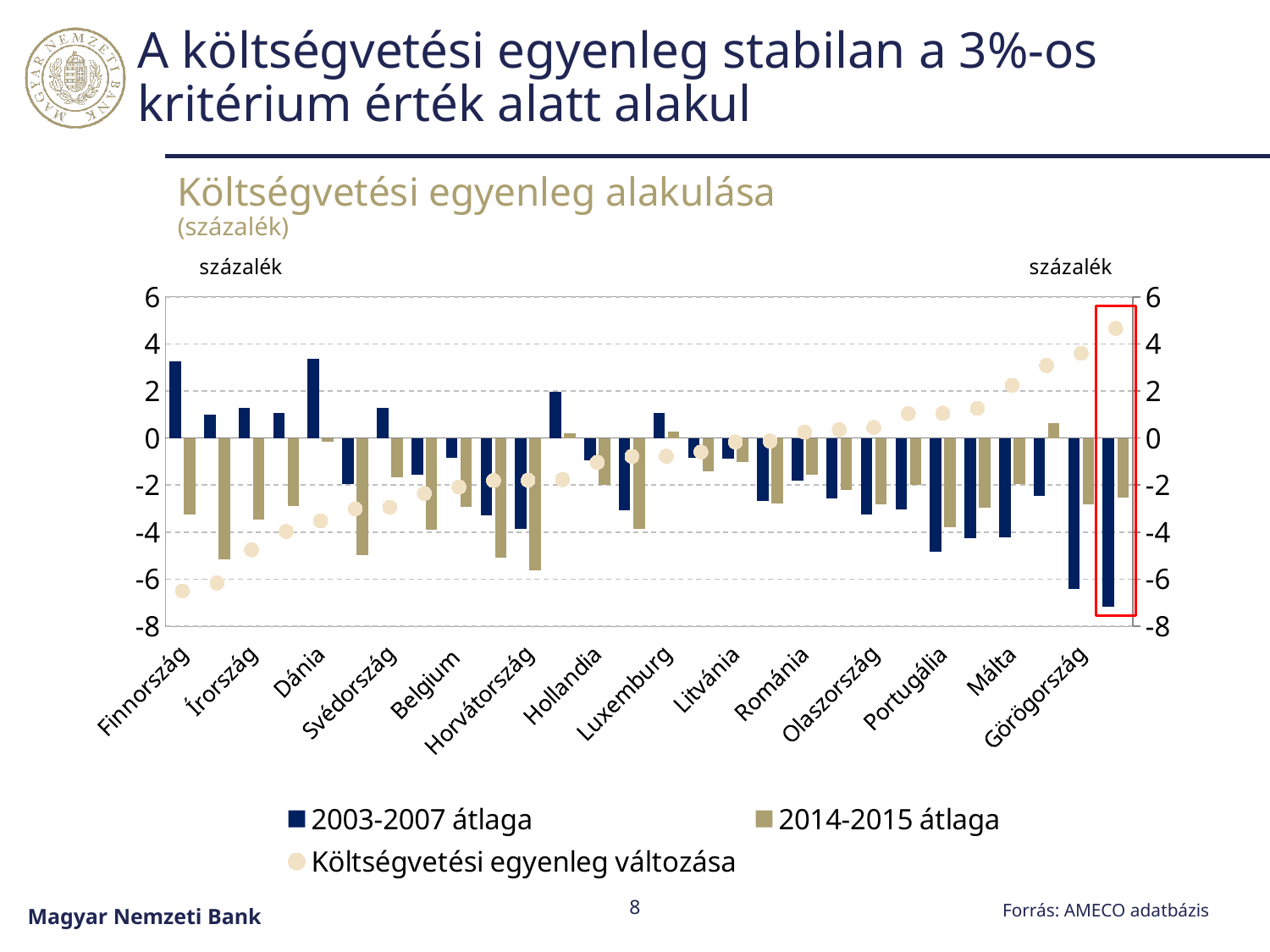
For Finnország, which is larger: the 2003-2007 átlaga or the 2014-2015 átlaga? 2003-2007 átlaga Is the 2003-2007 átlaga value for Finnország greater or less than 2? greater How many series does the legend list? 3 Do the Költségvetési egyenleg változása values rise or fall from left to right along the x axis? rise What is the title of the chart? Költségvetési egyenleg alakulása Is the Költségvetési egyenleg változása value for Finnország greater or less than -6? less What kind of chart is shown on the slide? Bar chart with dot markers Which country has the lowest Költségvetési egyenleg változása value? Finnország Is the Költségvetési egyenleg változása value for Görögország greater or less than 4? less